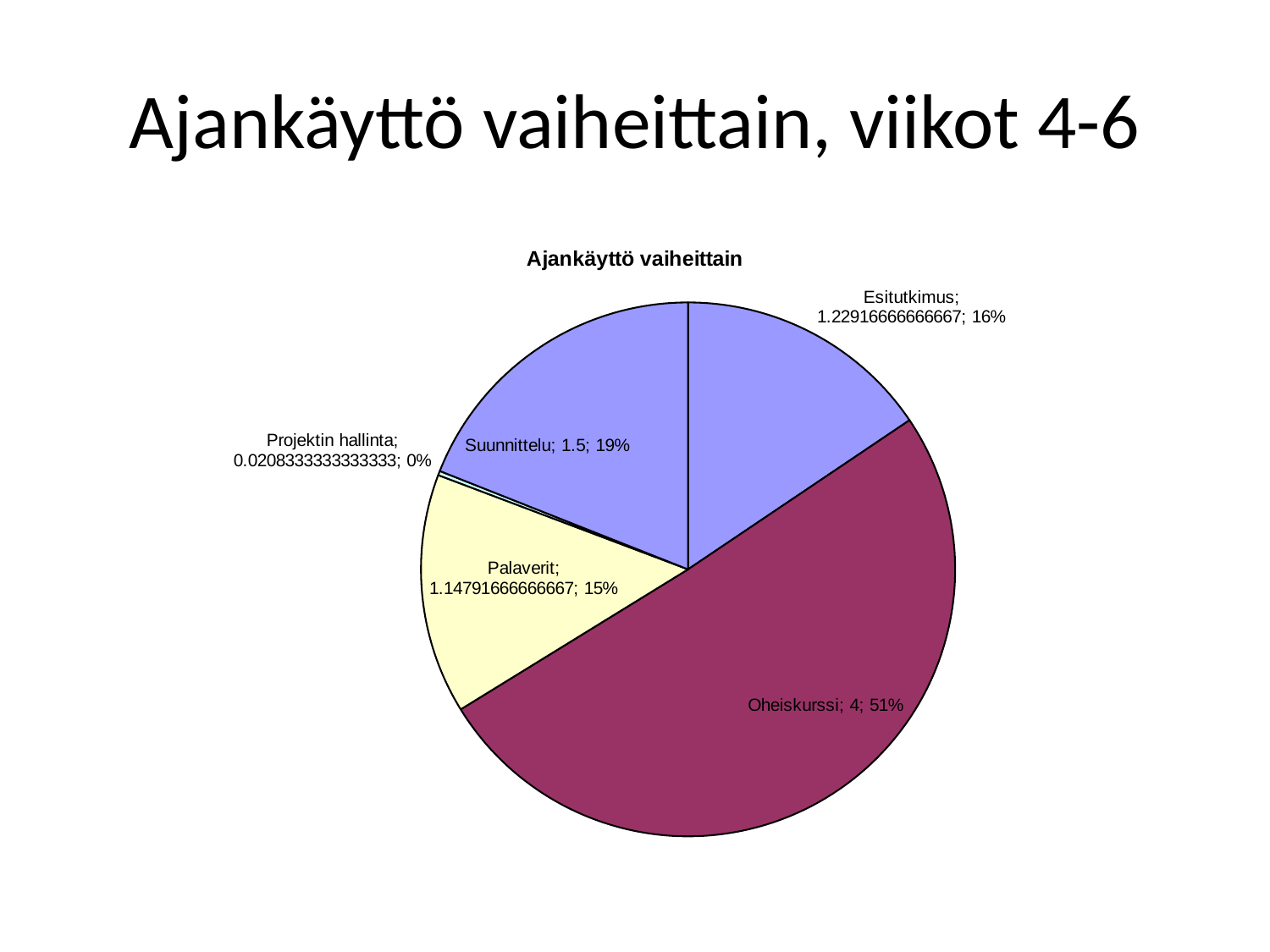
What share of the pie does Oheiskurssi take? 51% What share of the pie does Palaverit take? 15% Which category has the largest slice of the pie? Oheiskurssi What kind of chart is shown on the slide? Pie chart How many slices does the pie chart have? 5 What share of the pie does Esitutkimus take? 16% Which is larger, the slice for Suunnittelu or the slice for Palaverit? Suunnittelu Which category has the smallest slice of the pie? Projektin hallinta What value is shown for Suunnittelu? 1.5 What value is shown for Oheiskurssi? 4 What is the title of the chart? Ajankäyttö vaiheittain